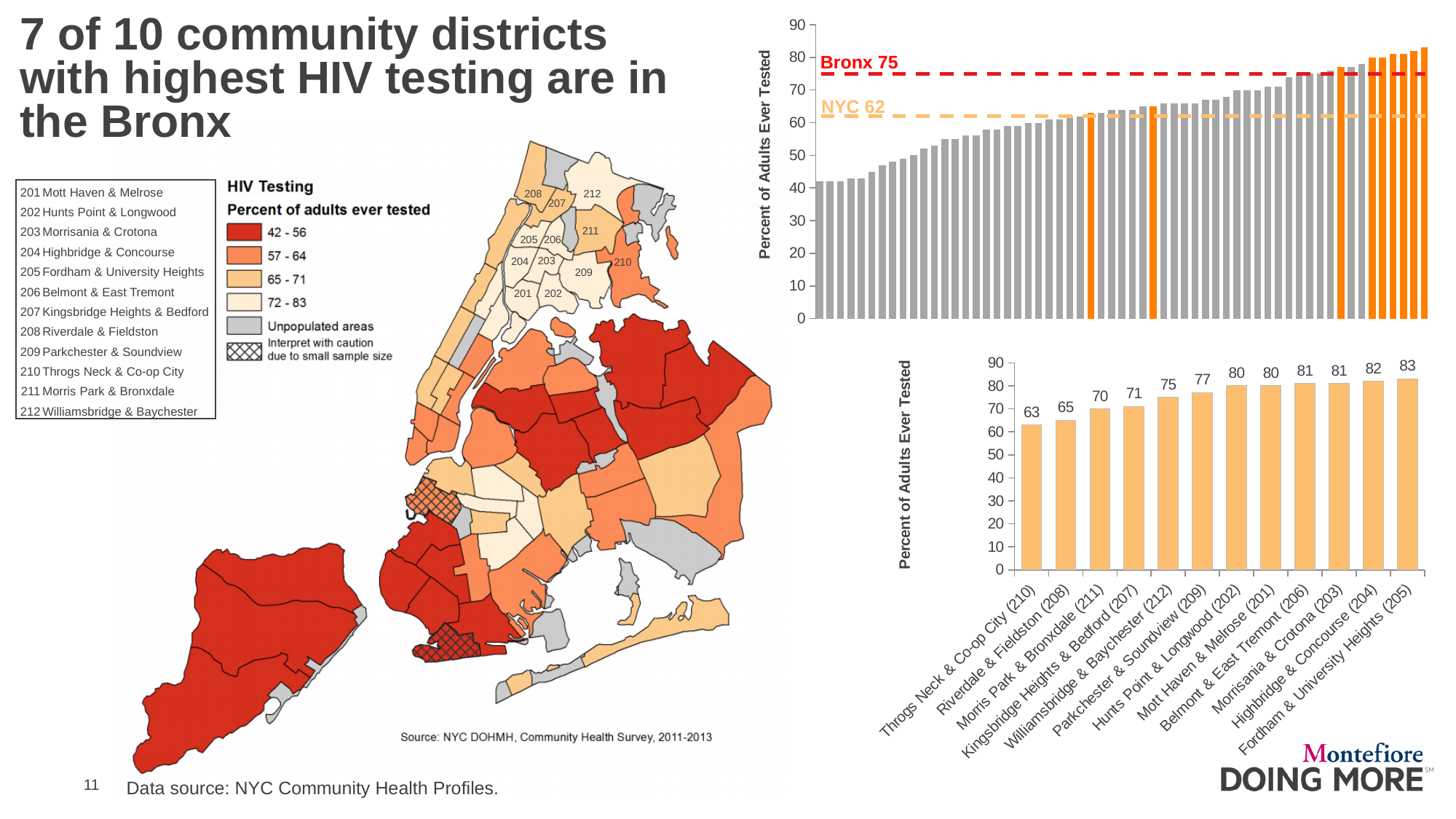
In the top-right bar chart, what value is the Bronx reference line labelled with? 75 How many community districts are shown in the bottom-right bar chart? 12 In the bottom-right bar chart, do the values rise or fall from left to right along the x axis? rise In the bottom-right bar chart, what is the value for Williamsbridge & Baychester (212)? 75 In the bottom-right bar chart, what is the value for Fordham & University Heights (205)? 83 In the bottom-right bar chart, what is the difference between the values for Fordham & University Heights (205) and Throgs Neck & Co-op City (210)? 20 In the top-right bar chart, what value is the NYC reference line labelled with? 62 What kind of chart is the bottom-right chart? bar chart In the bottom-right bar chart, which community district has the highest percent of adults ever tested? Fordham & University Heights (205) In the bottom-right bar chart, which is larger: the value for Parkchester & Soundview (209) or Morris Park & Bronxdale (211)? Parkchester & Soundview (209) In the bottom-right bar chart, which community district has the lowest percent of adults ever tested? Throgs Neck & Co-op City (210) In the bottom-right bar chart, what is the value for Throgs Neck & Co-op City (210)? 63